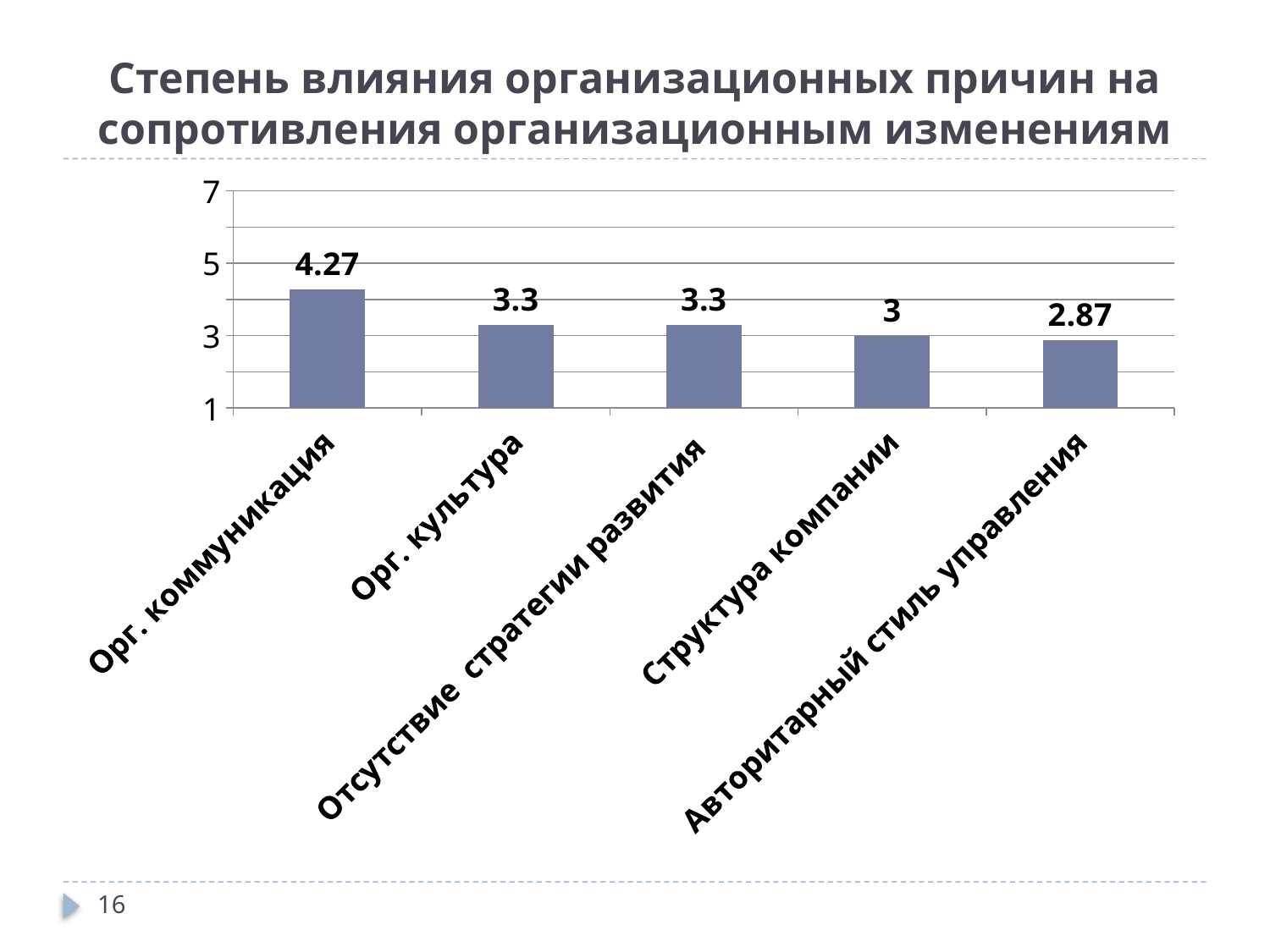
What is the value for Орг. коммуникация? 4.27 Which category has the highest value? Орг. коммуникация Which category has the lowest value? Авторитарный стиль управления Which is larger, the value for Орг. культура or the value for Структура компании? Орг. культура What is the difference between the values for Орг. коммуникация and Авторитарный стиль управления? 1.4 Is the value for Орг. коммуникация greater or less than 5? less What is the title of the slide? Степень влияния организационных причин на сопротивления организационным изменениям What is the difference between the values for Орг. культура and Структура компании? 0.3 What is the value for Авторитарный стиль управления? 2.87 What is the value for Структура компании? 3 How many categories are shown in the chart? 5 What kind of chart is shown on the slide? bar chart